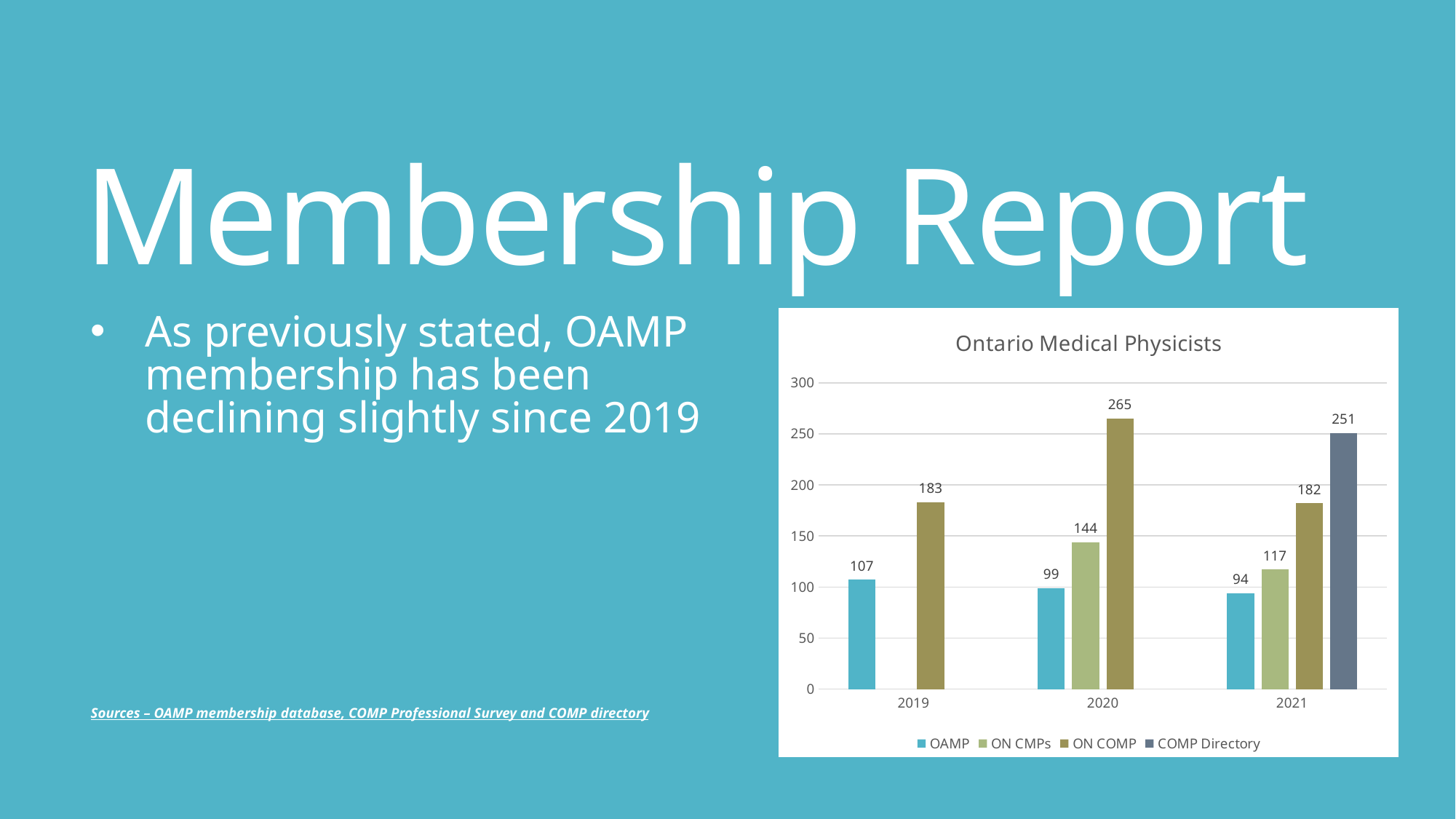
What is the ON CMPs value for 2021? 117 What is the COMP Directory value for 2021? 251 What is the ON COMP value for 2020? 265 How many series does the legend list? 4 What is the difference between the ON COMP values for 2020 and 2021? 83 How many years are shown on the x axis? 3 In which year is the ON COMP value highest? 2020 What is the OAMP value for 2019? 107 In which year is the OAMP value lowest? 2021 What kind of chart is shown? Bar chart Does the OAMP value rise or fall from 2019 to 2021? Fall Which is larger in 2021, the ON COMP value or the COMP Directory value? COMP Directory